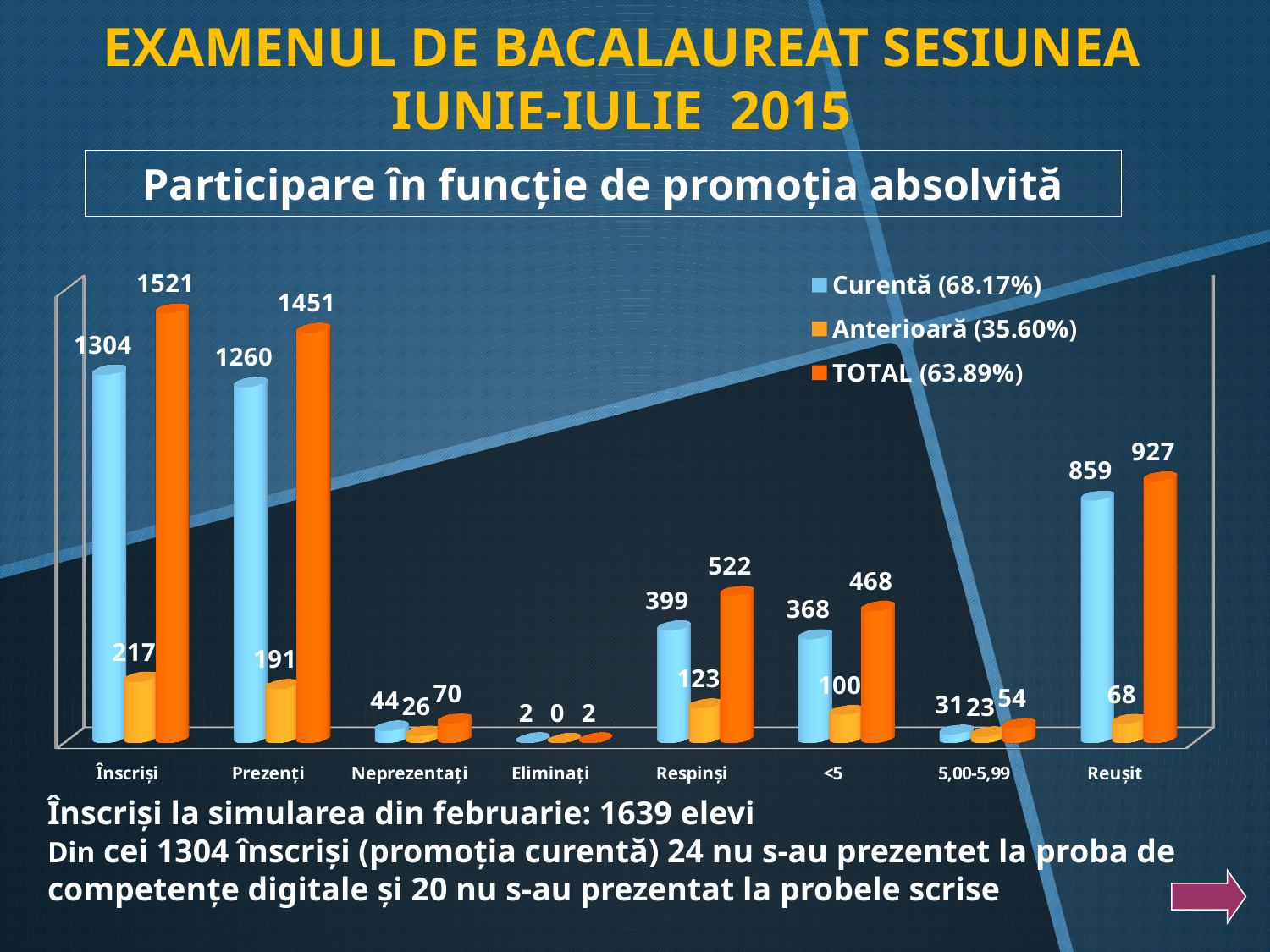
Which category has the lowest Curentă (68.17%) value? Eliminați How many series does the legend list? 3 What is the value for Curentă (68.17%) in the Înscriși category? 1304 How many categories are shown on the x axis? 8 What is the title shown in the box above the chart? Participare în funcție de promoția absolvită What is the difference between the TOTAL (63.89%) values for Înscriși and Prezenți? 70 Which category has the highest TOTAL (63.89%) value? Înscriși What is the TOTAL (63.89%) value for the Reușit category? 927 What kind of chart is shown on the slide? Bar chart What is the value for Anterioară (35.60%) in the Eliminați category? 0 What is the value for Anterioară (35.60%) in the Prezenți category? 191 Which is larger: the Curentă (68.17%) value for Respinși or for <5? Respinși